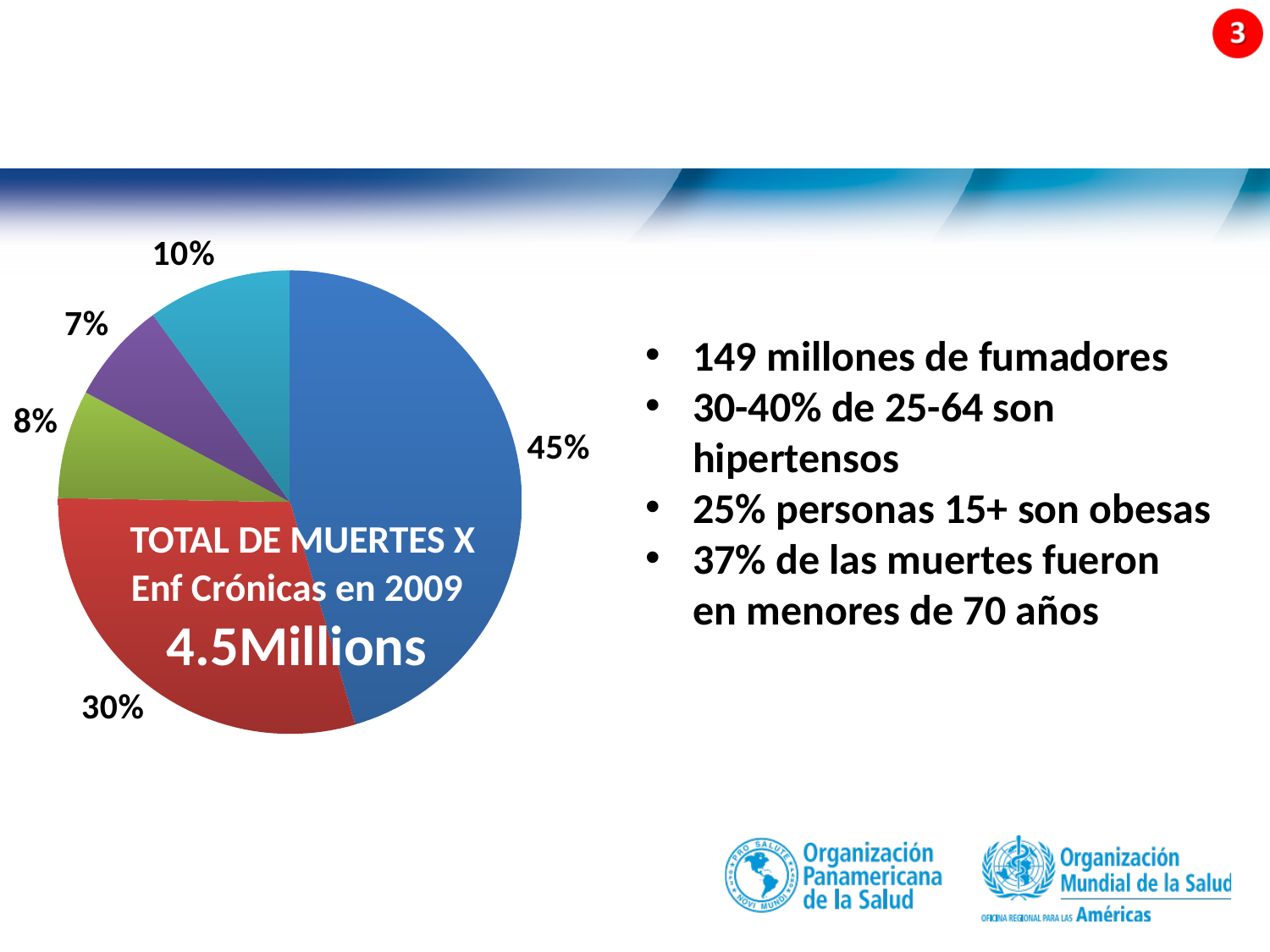
Which slice is larger in the pie chart, the teal slice or the green slice? teal slice How many slices does the pie chart have? 5 What percentage is shown for the red slice of the pie chart? 30% What is the largest share shown in the pie chart? 45% What is the difference in percentage points between the blue slice and the red slice of the pie chart? 15 What total number of deaths is printed on the pie chart? 4.5Millions What percentage is shown for the blue slice of the pie chart? 45% What is the smallest share shown in the pie chart? 7% What kind of chart is shown on the slide? pie chart What percentage is shown for the green slice of the pie chart? 8% What percentage is shown for the teal slice of the pie chart? 10% What percentage is shown for the purple slice of the pie chart? 7%